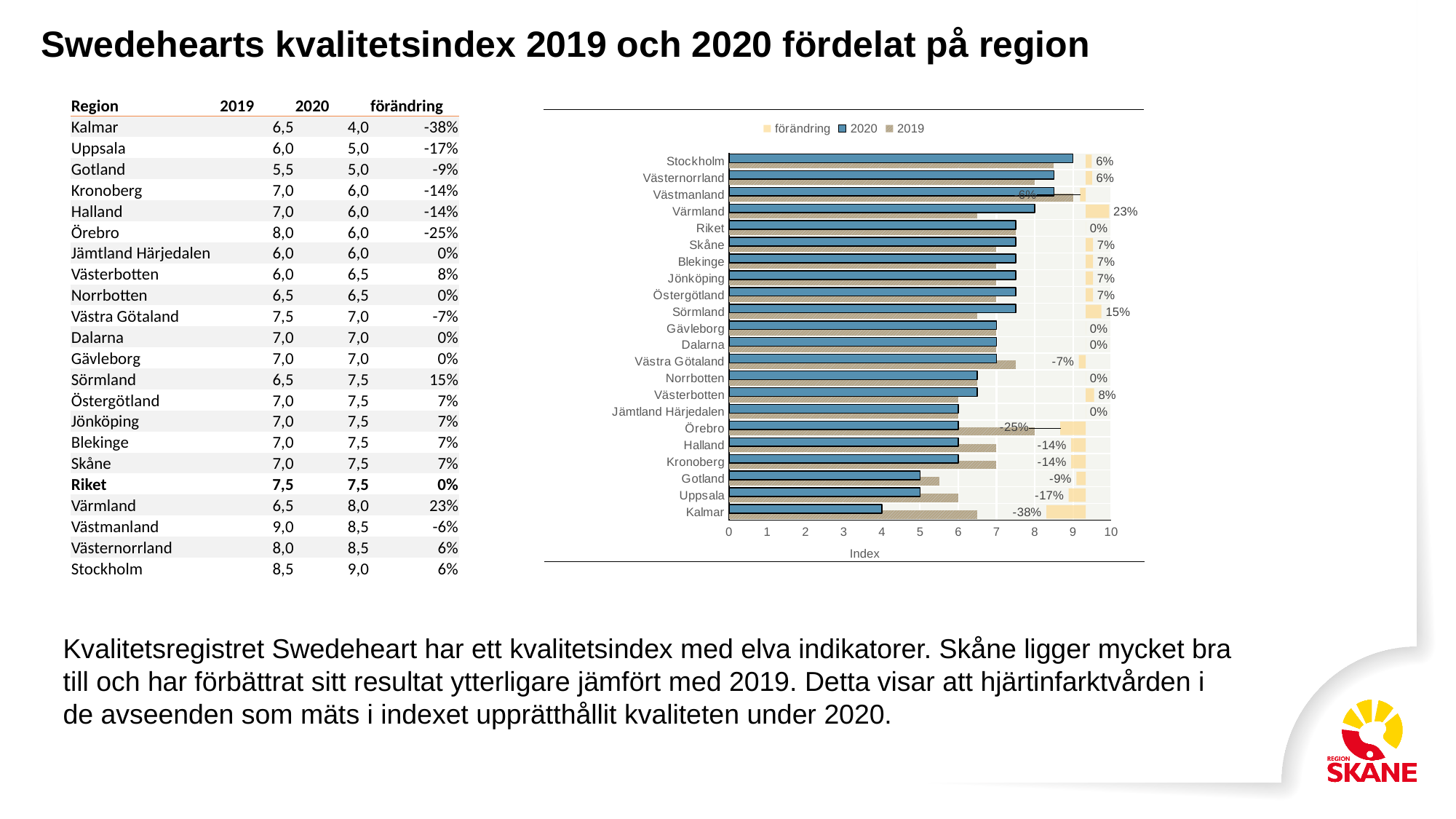
What kind of chart is shown on the slide? bar chart What is the förändring value shown for Kalmar? -38% What is the title of the horizontal axis of the chart? Index What is the förändring value shown for Värmland? 23% Which region has the lowest förändring value? Kalmar Which region has the highest förändring value? Värmland Is the 2019 index value for Västmanland greater or less than 8? greater How many regions (categories) are plotted on the chart? 22 Which region has the highest 2020 index bar? Stockholm Which region has the lowest 2020 index bar? Kalmar How many series does the chart legend list? 3 What is the difference between the förändring values for Värmland and Sörmland? 8 percentage points